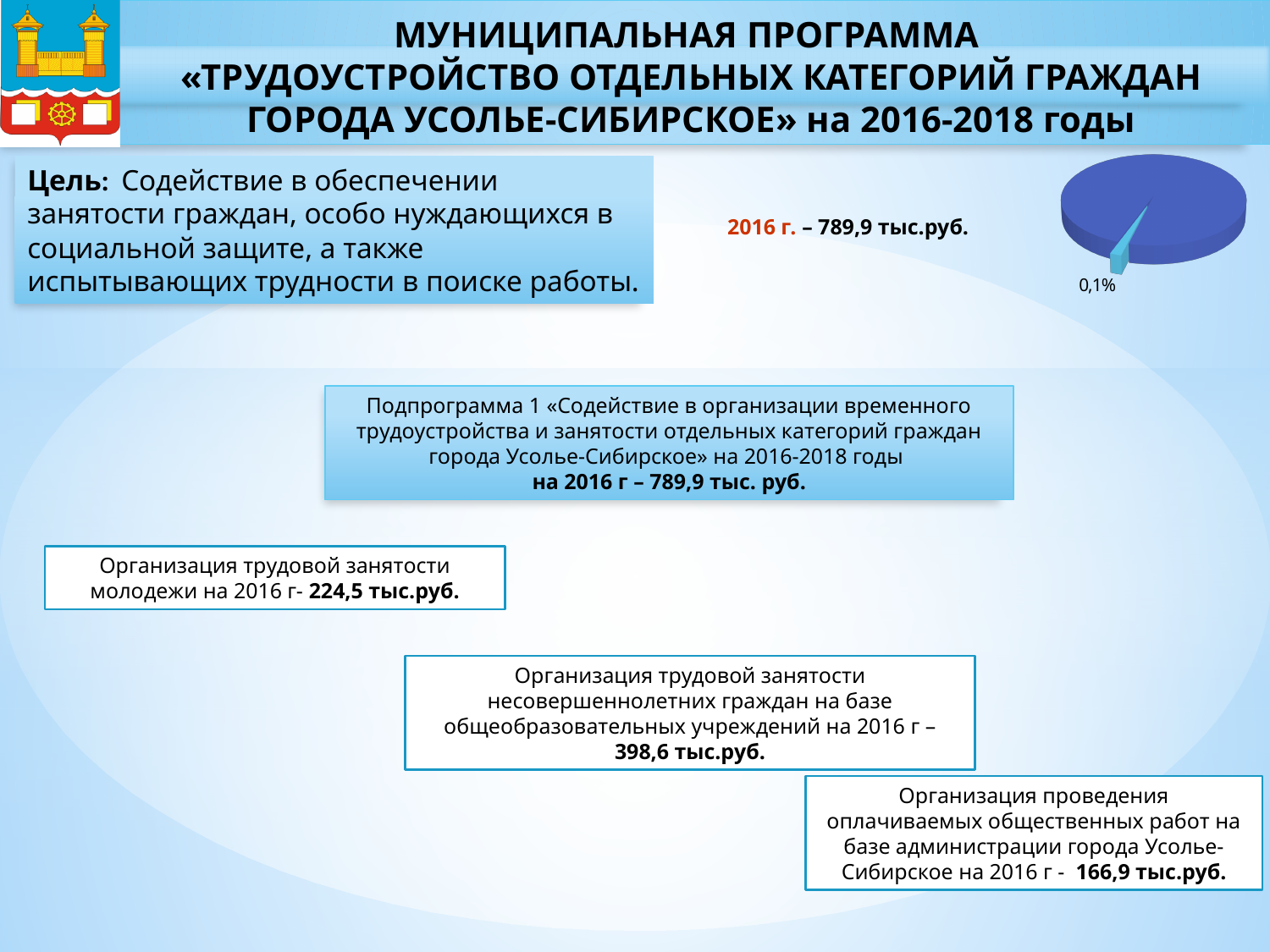
Which slice of the pie chart is the smallest? the slice labeled 0,1% What colour is the large slice of the pie chart? blue What share of the pie does the small light-blue slice represent? 0,1% How many slices does the pie chart have? 2 What percentage label is printed on the small slice of the pie chart? 0,1% Is the slice labeled 0,1% larger or smaller than the other slice of the pie chart? smaller What kind of chart is shown in the top right of the slide? pie chart